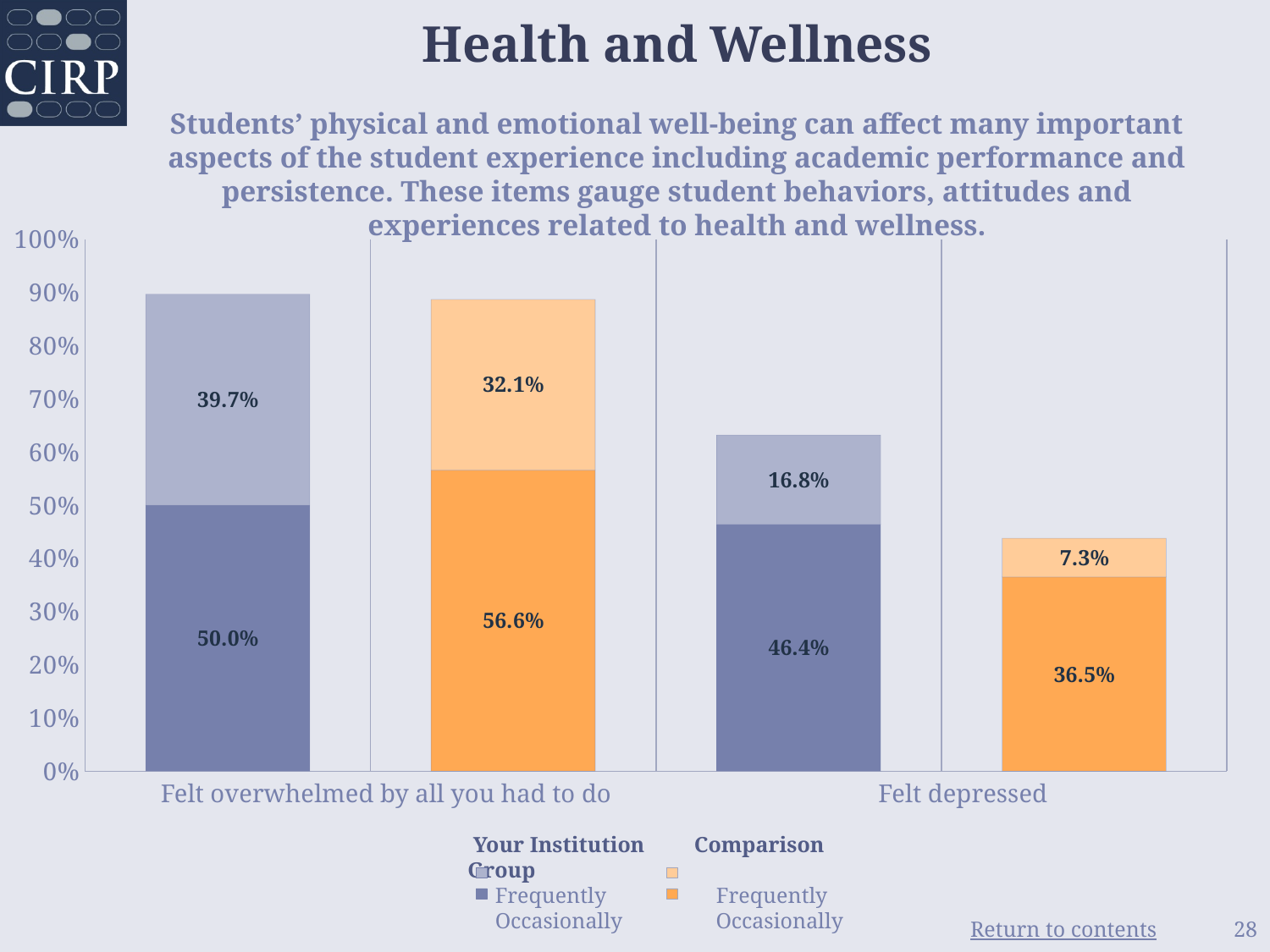
How many categories are shown on the x axis? 2 What is the title of the slide containing the chart? Health and Wellness What percentage of the Comparison Group reported occasionally feeling depressed? 36.5% What percentage of students at Your Institution reported occasionally feeling depressed? 46.4% What is the total of the Your Institution stacked bar for 'Felt overwhelmed by all you had to do'? 89.7% What is the total of the Comparison Group stacked bar for 'Felt depressed'? 43.8% What percentage of the Comparison Group reported frequently feeling overwhelmed by all they had to do? 32.1% What is the difference between the Your Institution and Comparison Group 'Frequently' values for 'Felt depressed'? 9.9% What percentage of students at Your Institution reported frequently feeling overwhelmed by all they had to do? 39.7% Which segment has the lowest value on the chart? Comparison Group Frequently, Felt depressed (7.3%) What type of chart is shown on the slide? Stacked bar chart Which is larger for 'Felt overwhelmed by all you had to do': the Your Institution 'Frequently' value or the Comparison Group 'Frequently' value? Your Institution